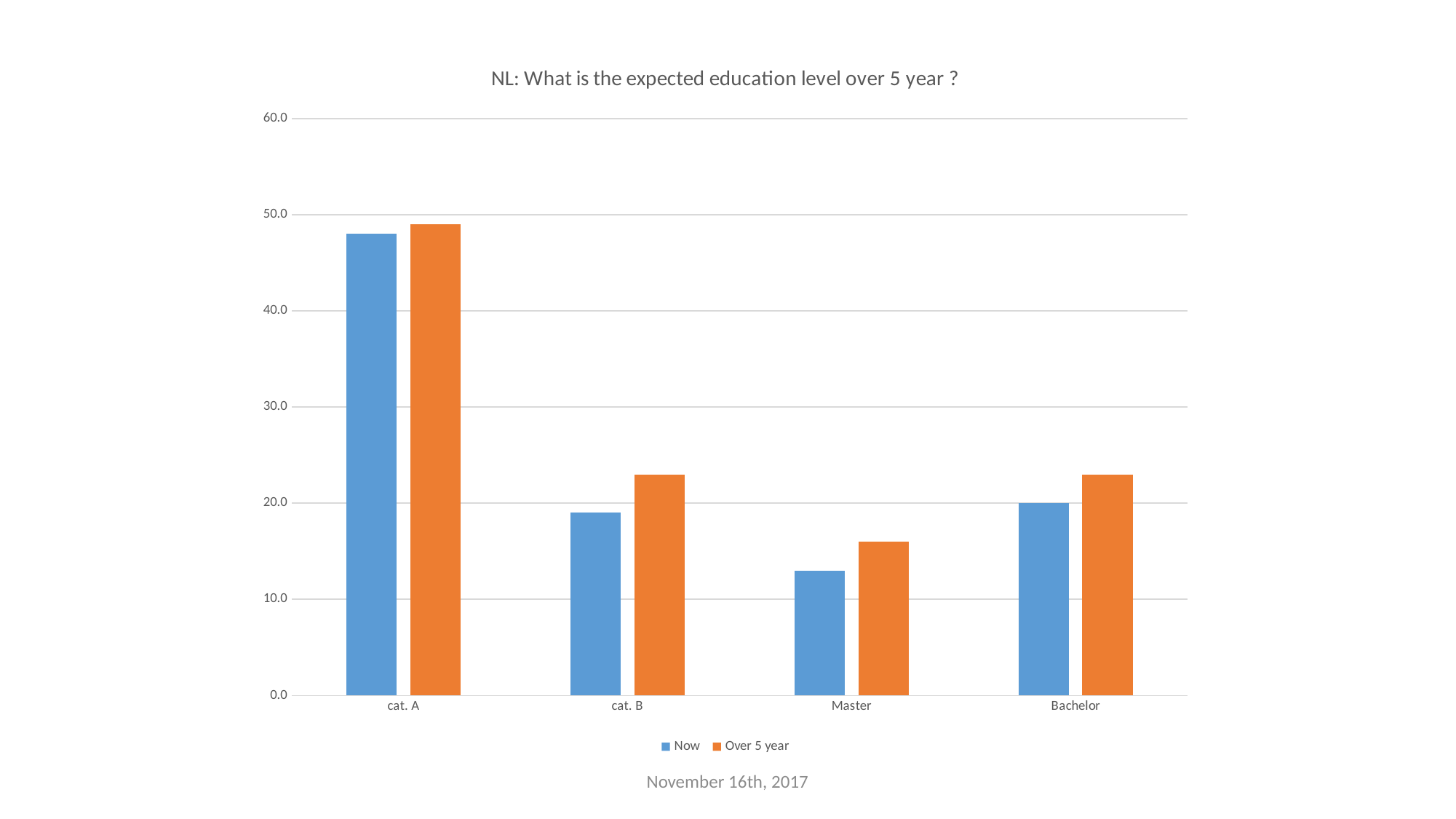
What kind of chart is shown on the slide? bar chart Which is larger for the Now series: cat. B or Master? cat. B Which category has the lowest value for the Now series? Master How many series does the legend list? 2 Is the value for Master in the Over 5 year series greater or less than 20.0? less Which category has the highest value for the Now series? cat. A Which is larger for cat. B: the Now value or the Over 5 year value? Over 5 year How many categories are shown on the x axis? 4 Which category has the lowest value for the Over 5 year series? Master Is the value for cat. B in the Over 5 year series greater or less than 20.0? greater Is the value for cat. A in the Now series greater or less than 40.0? greater What is the title of the chart? NL: What is the expected education level over 5 year ?